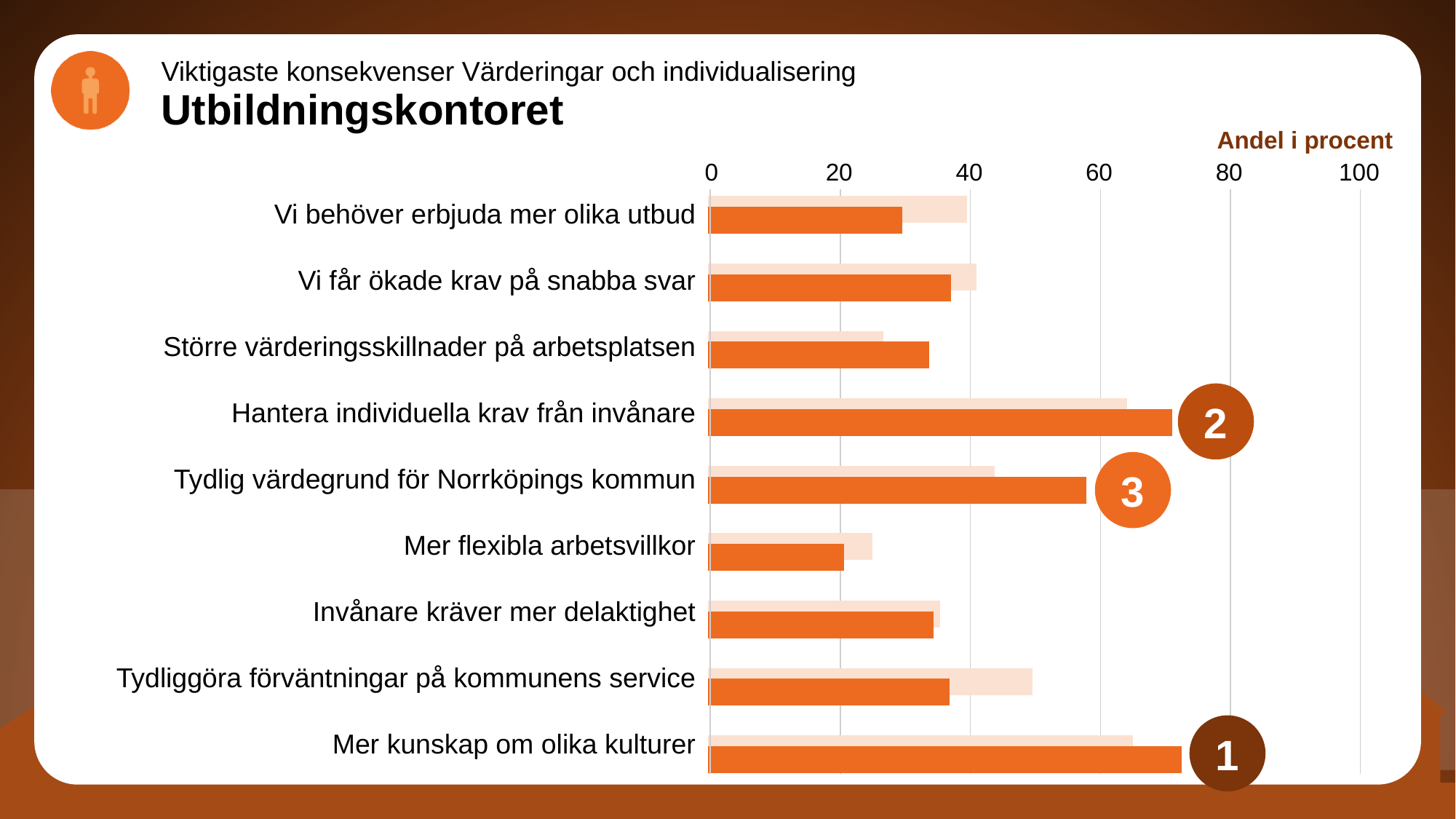
Which has the longer dark orange bar: "Hantera individuella krav från invånare" or "Mer flexibla arbetsvillkor"? Hantera individuella krav från invånare Is the dark orange bar for "Vi behöver erbjuda mer olika utbud" greater or less than 40? less How many categories are plotted in the chart? 9 What label is shown above the horizontal axis of the chart? Andel i procent What kind of chart is shown on the slide? bar chart Is the dark orange bar for "Hantera individuella krav från invånare" greater or less than 60? greater Which has the longer light orange bar: "Tydliggöra förväntningar på kommunens service" or "Invånare kräver mer delaktighet"? Tydliggöra förväntningar på kommunens service What is the title of the chart? Utbildningskontoret Which category has the shortest dark orange bar? Mer flexibla arbetsvillkor Is the dark orange bar for "Mer kunskap om olika kulturer" greater or less than 60? greater